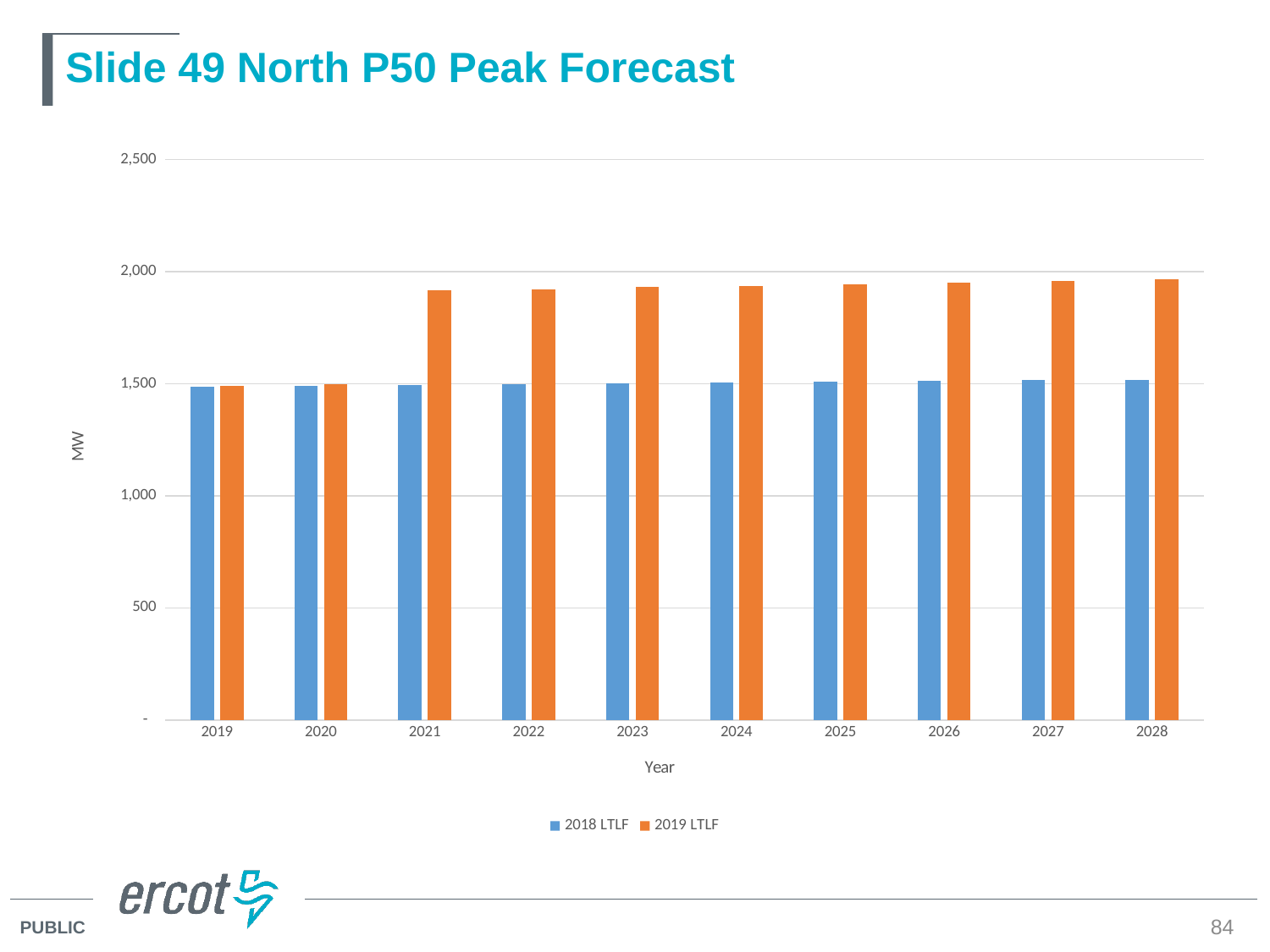
Is the 2018 LTLF value for 2028 greater or less than 2,000? less Is the 2019 LTLF value for 2021 greater or less than 2,000? less What kind of chart is shown on the slide? bar chart How many series does the legend list? 2 For 2021, which series has the larger value, 2018 LTLF or 2019 LTLF? 2019 LTLF How many years are shown on the x axis? 10 For 2026, which series has the larger value, 2018 LTLF or 2019 LTLF? 2019 LTLF What unit is shown on the y axis label? MW Do the 2019 LTLF values generally rise or fall from 2019 to 2028? rise Which series is shown in orange? 2019 LTLF Is the 2018 LTLF value for 2019 greater or less than 1,000? greater